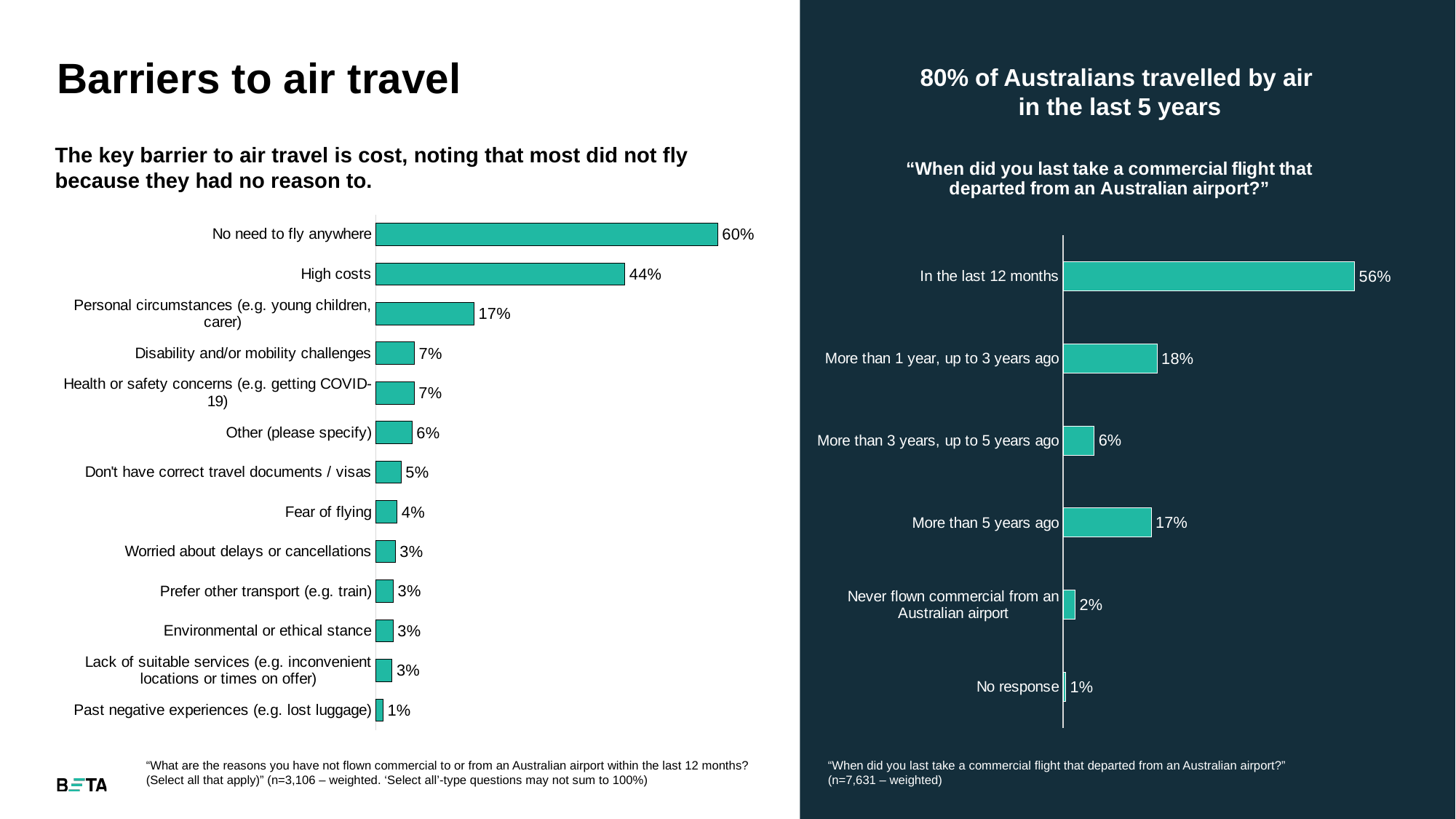
In the left chart on barriers to air travel, how many categories are shown? 13 In the right chart on when Australians last took a commercial flight, how many categories are shown? 6 In the right chart on when Australians last took a commercial flight, what is the difference between In the last 12 months and More than 1 year, up to 3 years ago? 38% In the right chart on when Australians last took a commercial flight, which category has the highest value? In the last 12 months In the right chart on when Australians last took a commercial flight, which is larger: More than 1 year, up to 3 years ago or More than 3 years, up to 5 years ago? More than 1 year, up to 3 years ago What type of chart is the right chart on when Australians last took a commercial flight? Bar chart In the left chart on barriers to air travel, which category has the lowest value? Past negative experiences (e.g. lost luggage) In the right chart on when Australians last took a commercial flight, what is the value for More than 5 years ago? 17% In the left chart on barriers to air travel, which category has the highest value? No need to fly anywhere In the left chart on barriers to air travel, what is the difference between No need to fly anywhere and High costs? 16% In the left chart on barriers to air travel, what is the value for Fear of flying? 4% In the left chart on barriers to air travel, what is the value for High costs? 44%